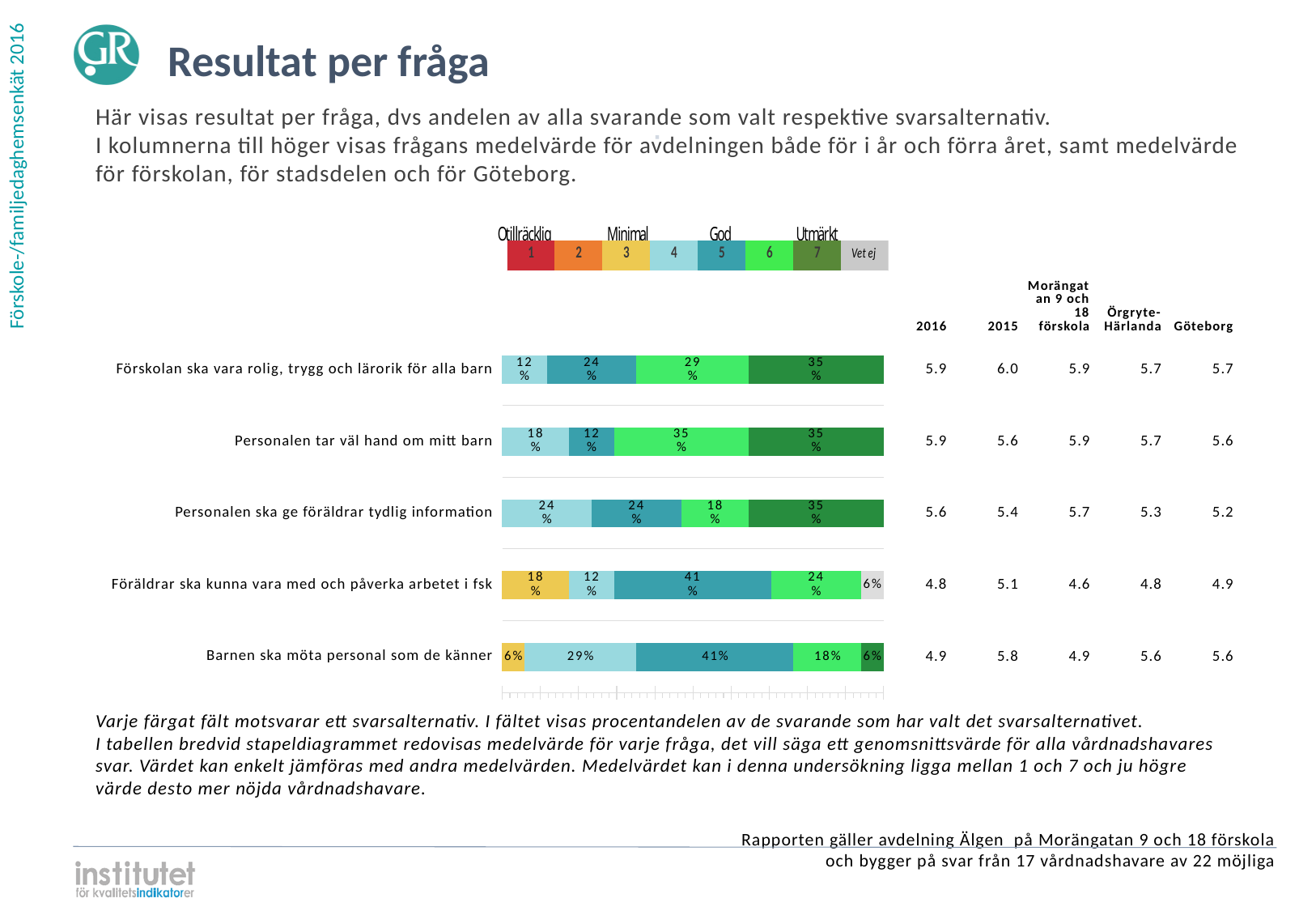
What percentage of respondents answered 'Vet ej' for 'Föräldrar ska kunna vara med och påverka arbetet i fsk'? 6% What type of chart is shown on the slide? bar chart For 'Personalen ska ge föräldrar tydlig information', what is the difference between the share for answer 7 and the share for answer 6? 17% What is the 2016 mean value shown for 'Personalen ska ge föräldrar tydlig information'? 5.6 What label does the legend give to answer alternatives 1 and 2? Otillräcklig Which answer alternative has the largest share for 'Föräldrar ska kunna vara med och påverka arbetet i fsk'? 5 How many entries does the colour legend above the chart list? 8 What percentage of respondents chose answer 7 (Utmärkt) for 'Förskolan ska vara rolig, trygg och lärorik för alla barn'? 35% How many questions (categories) are plotted in the bar chart? 5 What percentage of respondents chose answer 5 for 'Barnen ska möta personal som de känner'? 41% For 'Barnen ska möta personal som de känner', which is larger: the share for answer 4 or the share for answer 6? answer 4 What percentage of respondents chose answer 6 for 'Personalen tar väl hand om mitt barn'? 35%